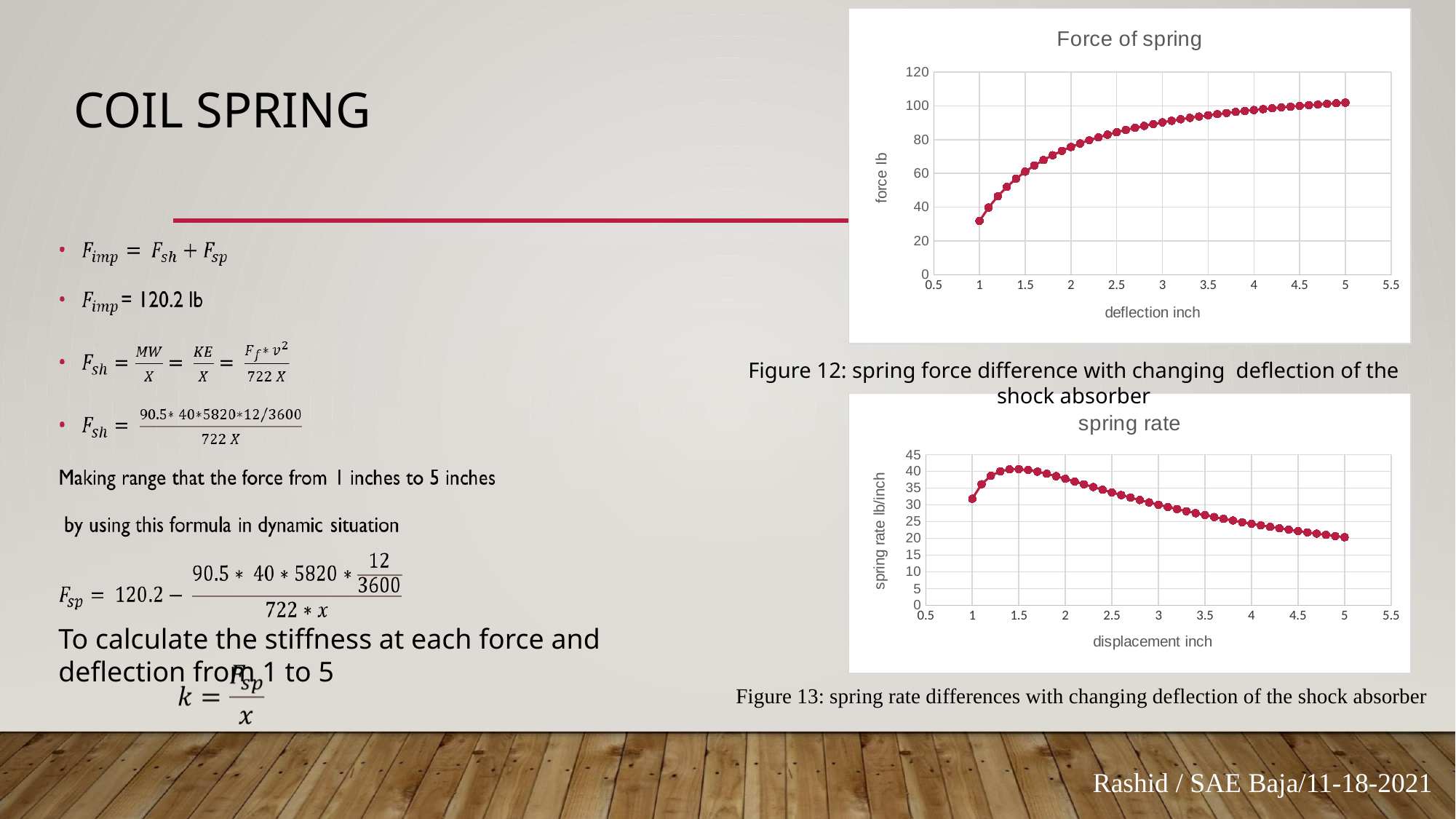
In the "spring rate" chart, does the spring rate rise or fall as displacement increases from 2 to 5 inches? fall In the "spring rate" chart, is the spring rate at a displacement of 1.5 inches greater or less than 35? greater In the "spring rate" chart, is the spring rate at a displacement of 5 inches greater or less than 25? less In the "Force of spring" chart, is the force at a deflection of 5 inches greater or less than 80? greater In the "Force of spring" chart, does the force rise or fall as deflection increases from 1 to 5 inches? rise What is the y-axis title of the "Force of spring" chart? force lb What kind of chart is the "Force of spring" chart? scatter chart In the "Force of spring" chart, which has the larger force: a deflection of 2 inches or 3 inches? 3 inches In the "Force of spring" chart, at which deflection is the force highest? 5 In the "Force of spring" chart, at which deflection is the force lowest? 1 In the "spring rate" chart, which has the larger spring rate: a displacement of 1 inch or 5 inches? 1 inch